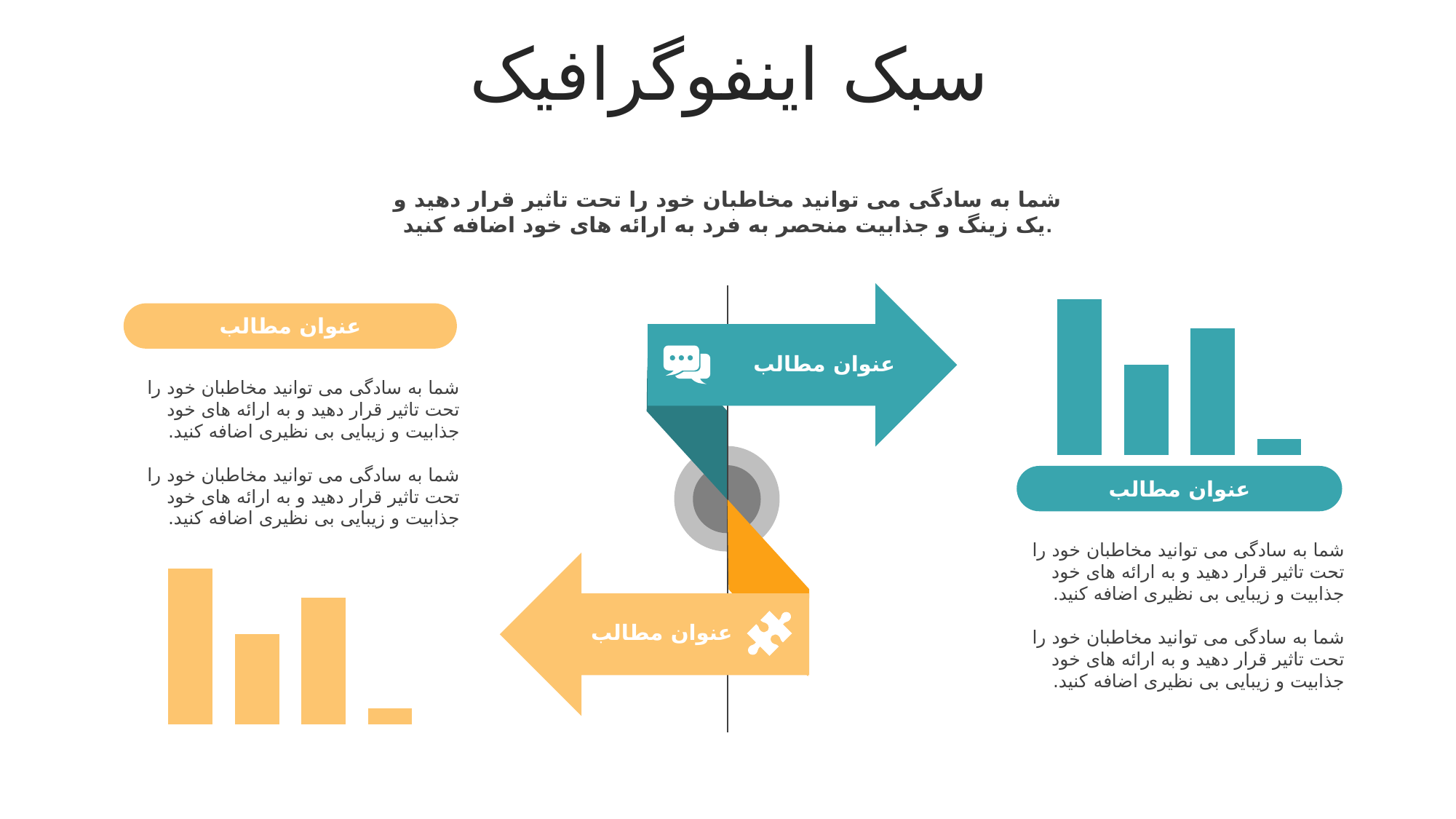
In the teal chart on the right side of the slide, which bar is the tallest: the leftmost, second, third, or rightmost? leftmost How many bars does the teal chart on the right side of the slide have? 4 What kind of chart is the teal chart on the right side of the slide? bar chart In the teal chart on the right side of the slide, is the second bar from the left taller or shorter than the third bar? shorter In the orange chart at the bottom left of the slide, which bar is the shortest: the leftmost, second, third, or rightmost? rightmost How many bars does the orange chart at the bottom left of the slide have? 4 What colour are the bars in the chart at the bottom left of the slide? orange In the orange chart at the bottom left of the slide, which bar is the tallest: the leftmost, second, third, or rightmost? leftmost In the teal chart on the right side of the slide, which bar is the shortest: the leftmost, second, third, or rightmost? rightmost In the orange chart at the bottom left of the slide, is the second bar from the left taller or shorter than the third bar? shorter What colour are the bars in the chart on the right side of the slide? teal What kind of chart is the orange chart at the bottom left of the slide? bar chart